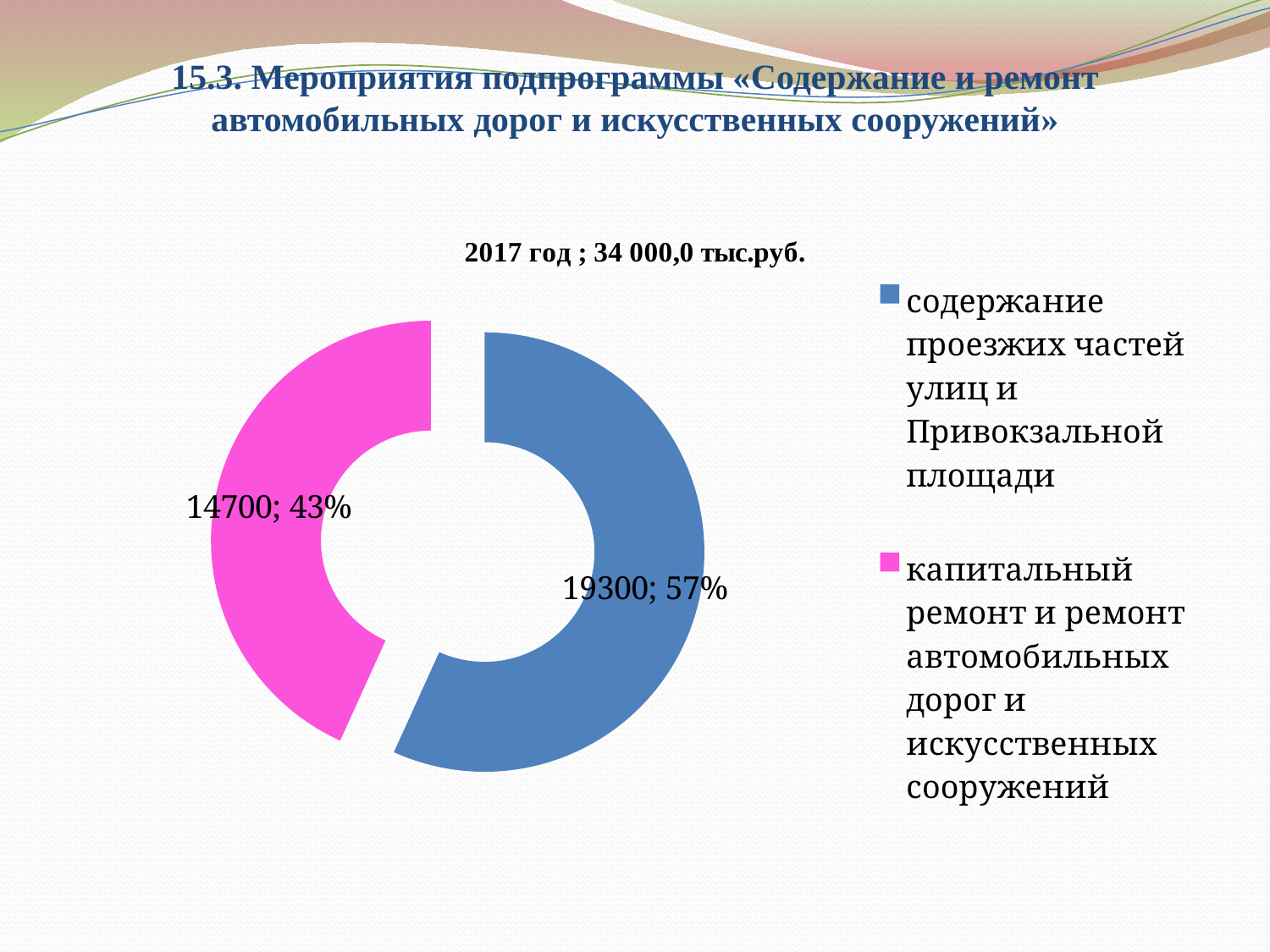
What share of the chart does «содержание проезжих частей улиц и Привокзальной площади» represent? 57% What kind of chart is shown on the slide? Doughnut (pie) chart What is the value for «капитальный ремонт и ремонт автомобильных дорог и искусственных сооружений»? 14700 How many categories does the chart show? 2 Which is larger: the value for «содержание проезжих частей улиц и Привокзальной площади» or for «капитальный ремонт и ремонт автомобильных дорог и искусственных сооружений»? содержание проезжих частей улиц и Привокзальной площади Which category has the largest value? содержание проезжих частей улиц и Привокзальной площади What is the difference between the values for «содержание проезжих частей улиц и Привокзальной площади» and «капитальный ремонт и ремонт автомобильных дорог и искусственных сооружений»? 4600 What share of the chart does «капитальный ремонт и ремонт автомобильных дорог и искусственных сооружений» represent? 43% What is the title of the chart? 2017 год ; 34 000,0 тыс.руб. What colour is the slice for «капитальный ремонт и ремонт автомобильных дорог и искусственных сооружений»? Pink What is the value for «содержание проезжих частей улиц и Привокзальной площади»? 19300 Which category has the smallest value? капитальный ремонт и ремонт автомобильных дорог и искусственных сооружений